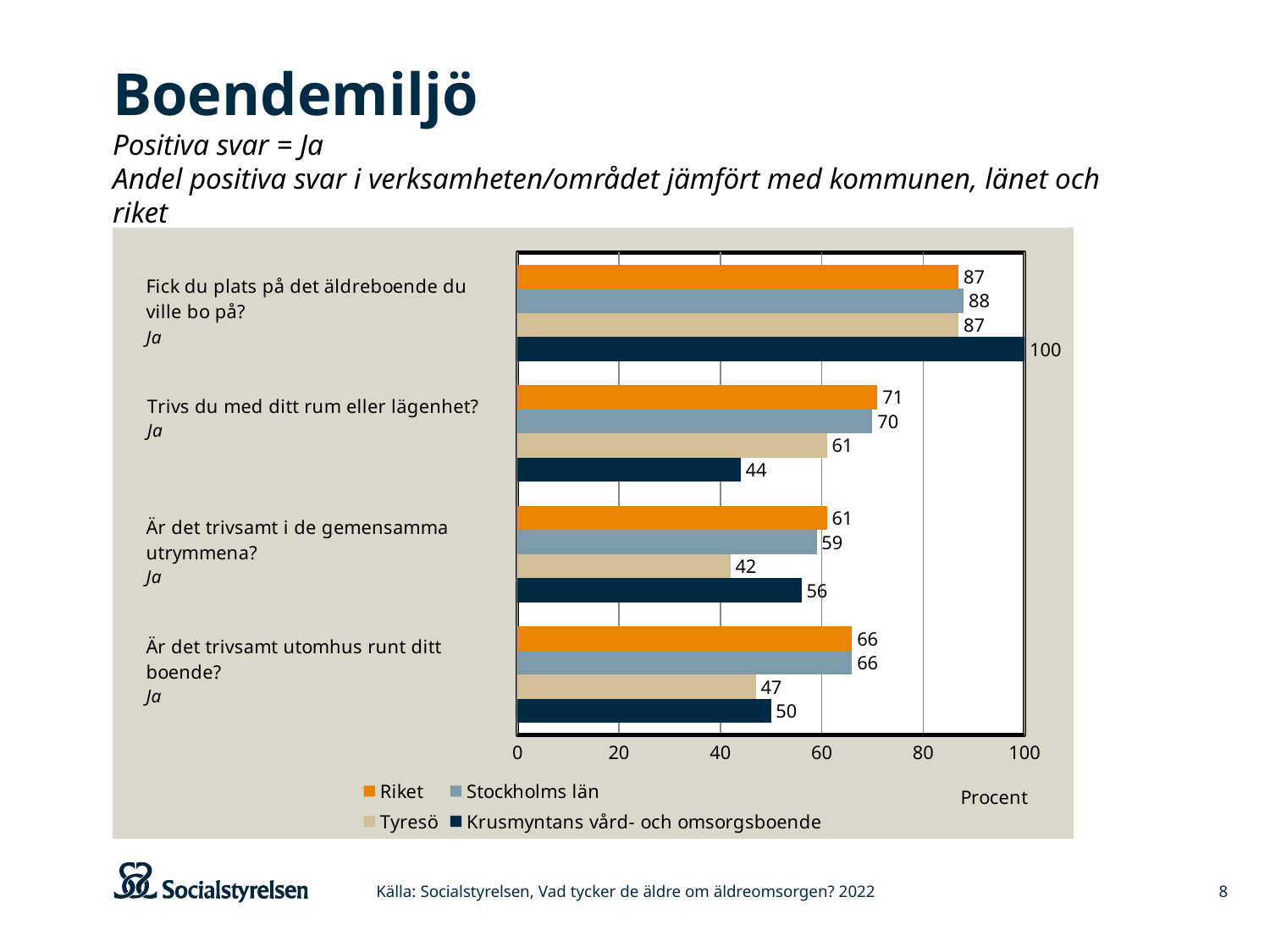
What value does Riket have for "Trivs du med ditt rum eller lägenhet?"? 71 What kind of chart is shown on the slide? bar chart How many series does the legend list? 4 For "Fick du plats på det äldreboende du ville bo på?", which series has the highest value? Krusmyntans vård- och omsorgsboende What is the difference between Riket and Krusmyntans vård- och omsorgsboende for "Trivs du med ditt rum eller lägenhet?"? 27 What value does Tyresö have for "Är det trivsamt i de gemensamma utrymmena?"? 42 How many question categories are shown on the chart? 4 Is the value for Tyresö on "Är det trivsamt utomhus runt ditt boende?" greater or less than 60? less What value does Stockholms län have for "Är det trivsamt utomhus runt ditt boende?"? 66 For "Är det trivsamt i de gemensamma utrymmena?", which is larger: Tyresö or Krusmyntans vård- och omsorgsboende? Krusmyntans vård- och omsorgsboende What value does Krusmyntans vård- och omsorgsboende have for "Fick du plats på det äldreboende du ville bo på?"? 100 For "Trivs du med ditt rum eller lägenhet?", which series has the lowest value? Krusmyntans vård- och omsorgsboende